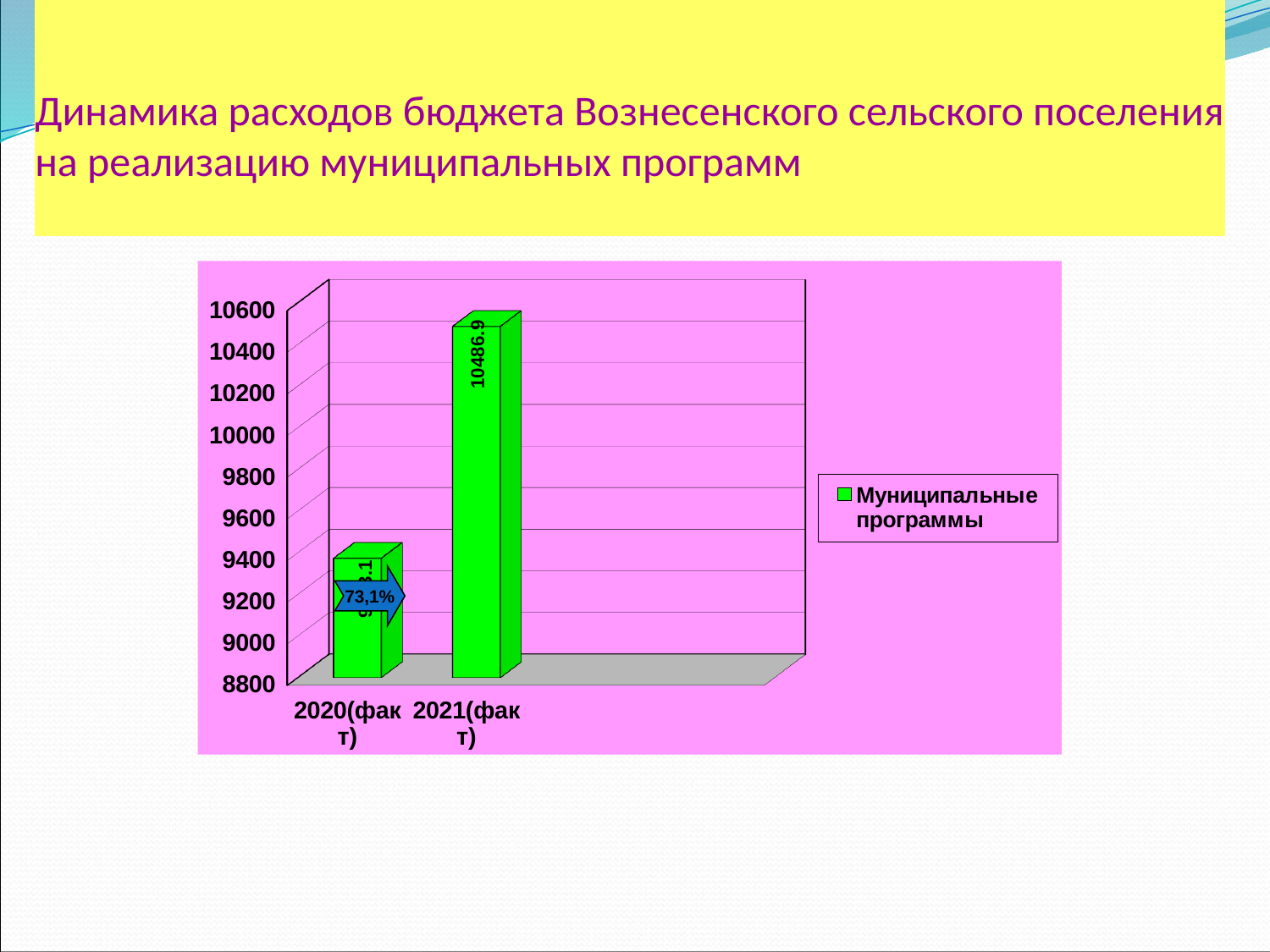
Which category has the highest value? 2021(факт) What is the value for 2021(факт)? 10486.9 How many series does the legend list? 1 How many categories are shown on the x axis? 2 Is the value for 2021(факт) greater or less than 10000? greater Do the values rise or fall from 2020(факт) to 2021(факт)? rise Is the value for 2020(факт) greater or less than 9000? greater What kind of chart is shown on the slide? bar chart Which category has the lowest value? 2020(факт) What series name is shown in the legend? Муниципальные программы Is the value for 2020(факт) greater or less than 10000? less Which is larger, the value for 2020(факт) or the value for 2021(факт)? 2021(факт)